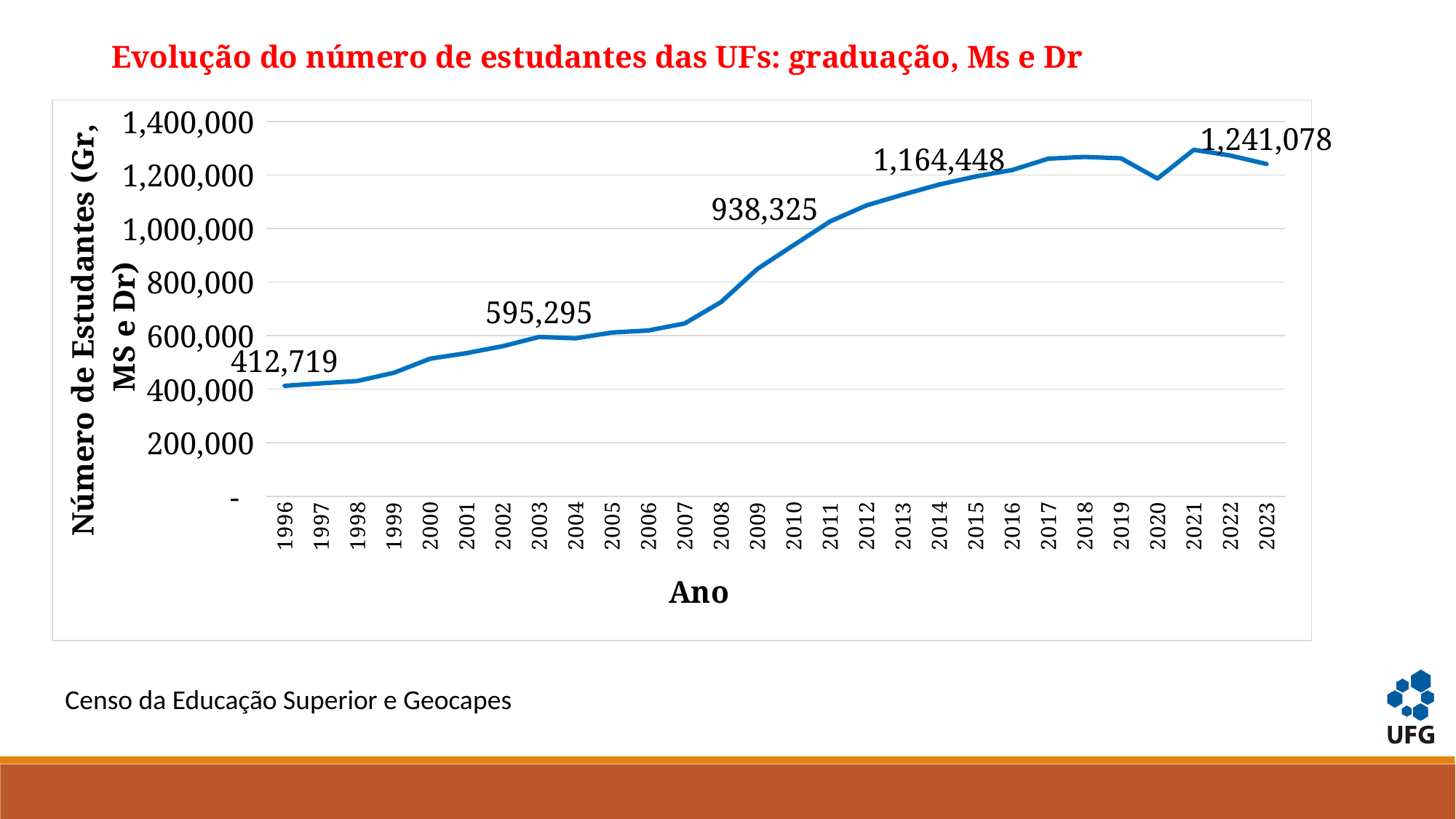
What is the number of students in 1996? 412,719 Is the value for 2021 greater or less than 1,200,000? greater What is the number of students in 2023? 1,241,078 How many years are shown on the x axis? 28 What is the number of students in 2010? 938,325 What is the number of students in 2003? 595,295 Is the value for 2007 greater or less than 600,000? greater By how much did the number of students increase from 1996 to 2023? 828,359 Which year has the lowest number of students? 1996 What kind of chart is shown on the slide? Line chart